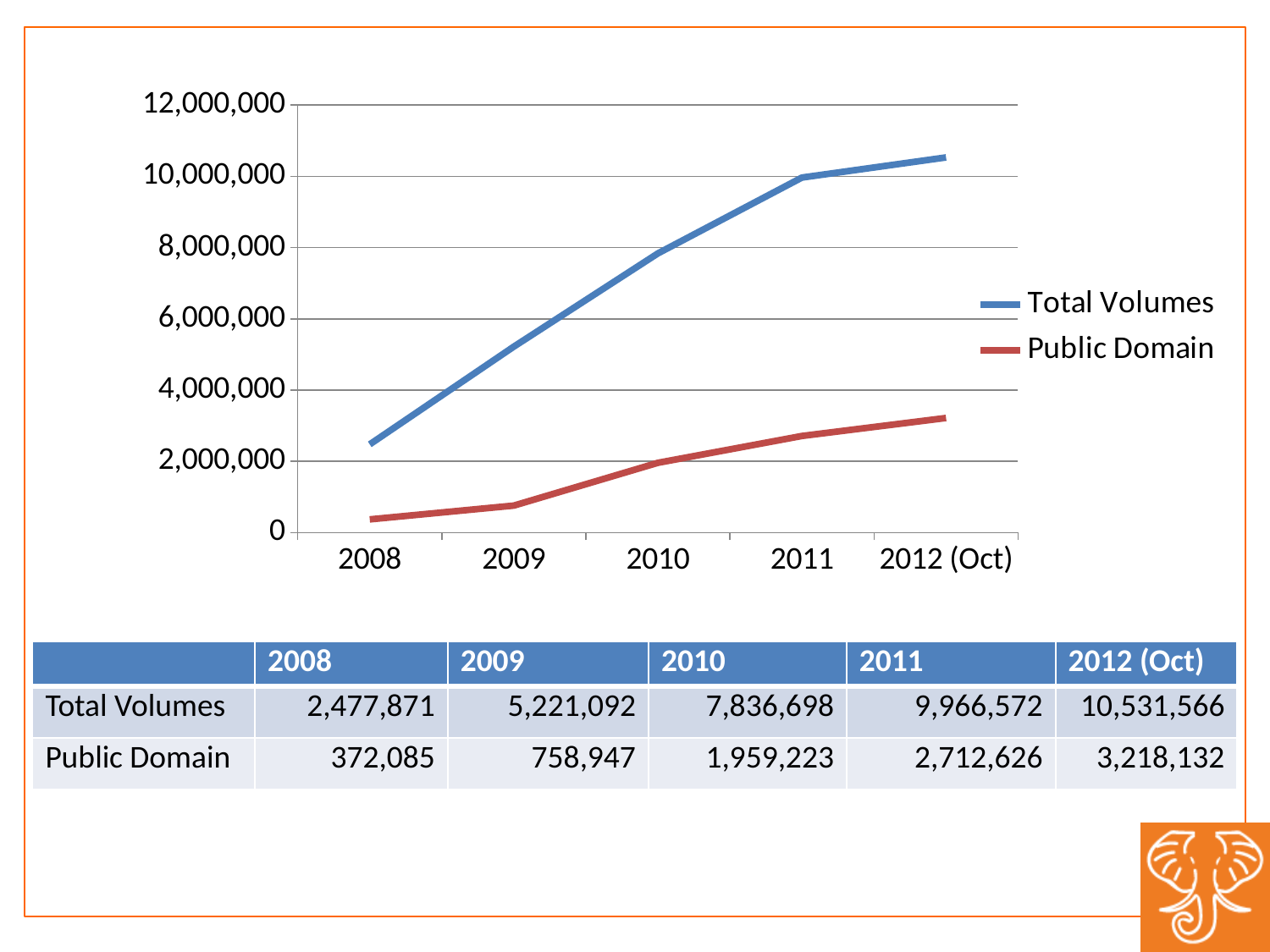
Does the Public Domain series rise or fall from 2008 to 2012 (Oct)? rise In which year is Public Domain lowest? 2008 What is the value of Public Domain in 2008? 372,085 What is the difference between Total Volumes and Public Domain in 2011? 7,253,946 How many series does the legend list? 2 What kind of chart is shown on the slide? line chart Which is larger in 2009, Total Volumes or Public Domain? Total Volumes What is the value of Total Volumes in 2010? 7,836,698 What is the value of Public Domain in 2012 (Oct)? 3,218,132 How many points are plotted along the x axis for each series? 5 What is the difference between Total Volumes in 2012 (Oct) and in 2008? 8,053,695 In which year is Total Volumes highest? 2012 (Oct)